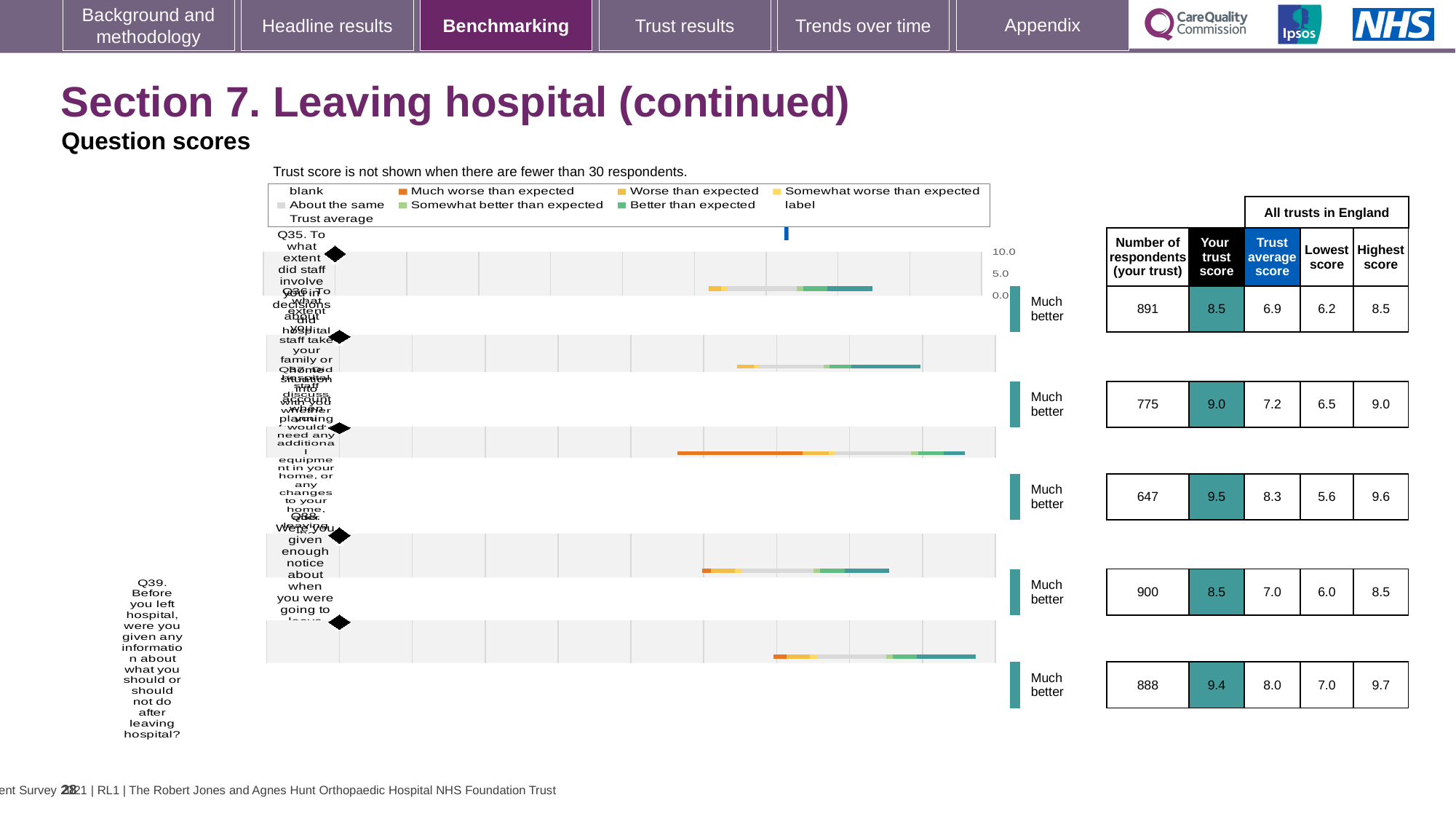
Which question has the highest 'Your trust score'? Q37 What is the trust average score for Q36? 7.2 Which question has the largest number of respondents (your trust)? Q38 What type of chart is used to show the question scores? Bar chart What is the difference between the 'Your trust score' and the trust average score for Q39? 1.4 Which question has the lowest 'Lowest score' among all trusts in England? Q37 What is the difference between the highest score and the lowest score for Q37? 4.0 What is the 'Your trust score' value for Q35? 8.5 How many questions are plotted in the chart? 5 What is the highest score across all trusts in England for Q39? 9.7 How many respondents (your trust) are shown for Q37? 647 Which has the larger 'Your trust score', Q36 or Q38? Q36